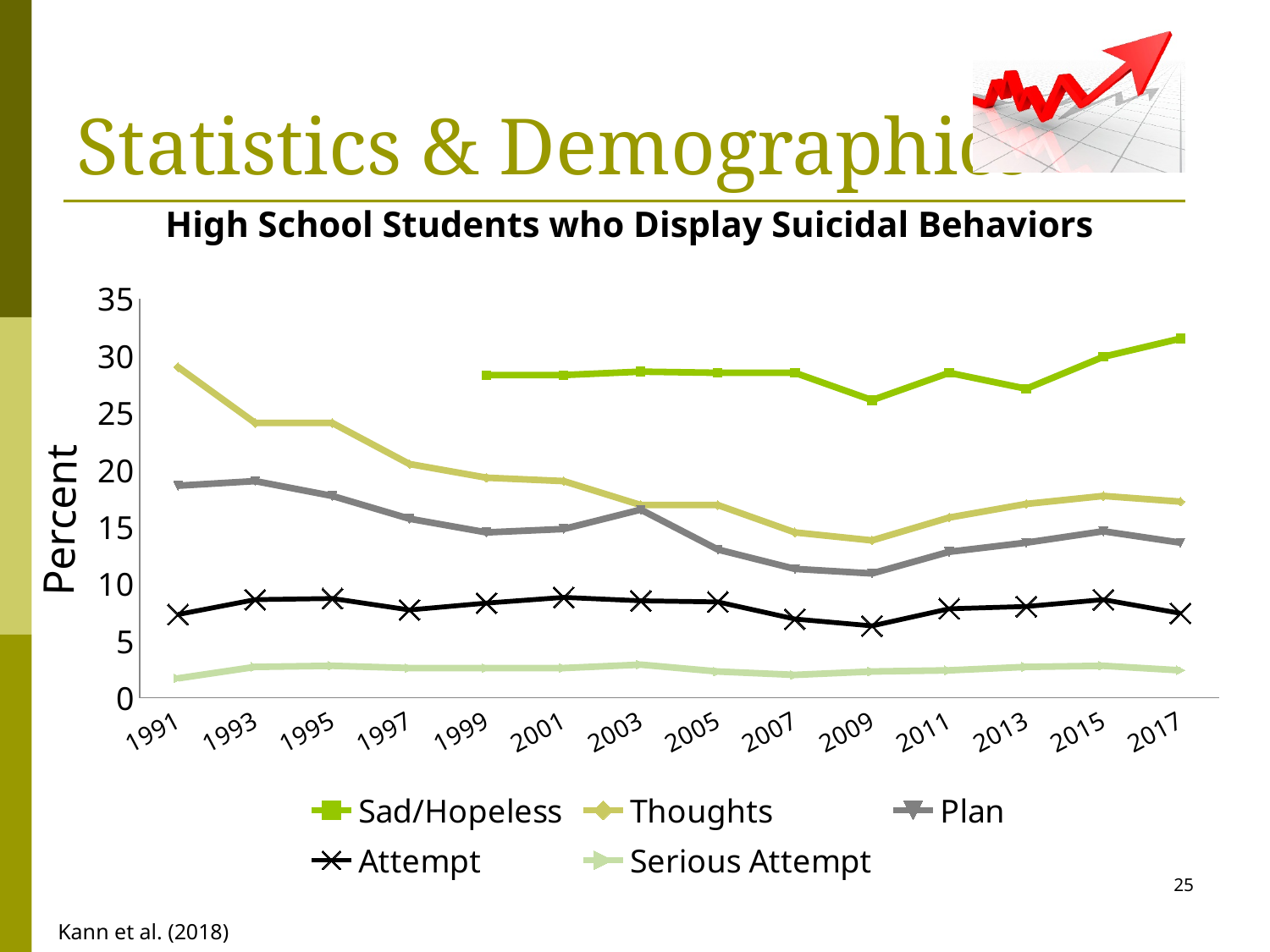
Is the value for Sad/Hopeless in 2017 greater or less than 30? greater How many years are labelled along the x axis? 14 Is the value for Thoughts in 1991 greater or less than 25? greater What is the title of the chart? High School Students who Display Suicidal Behaviors Which series has the highest value in 2017? Sad/Hopeless Which series has the lowest value in 1991? Serious Attempt What is the label on the y axis? Percent Does the Thoughts series rise or fall from 1991 to 2009? fall How many series does the legend list? 5 Is the value for Plan in 2009 greater or less than 15? less What kind of chart is shown on the slide? line chart